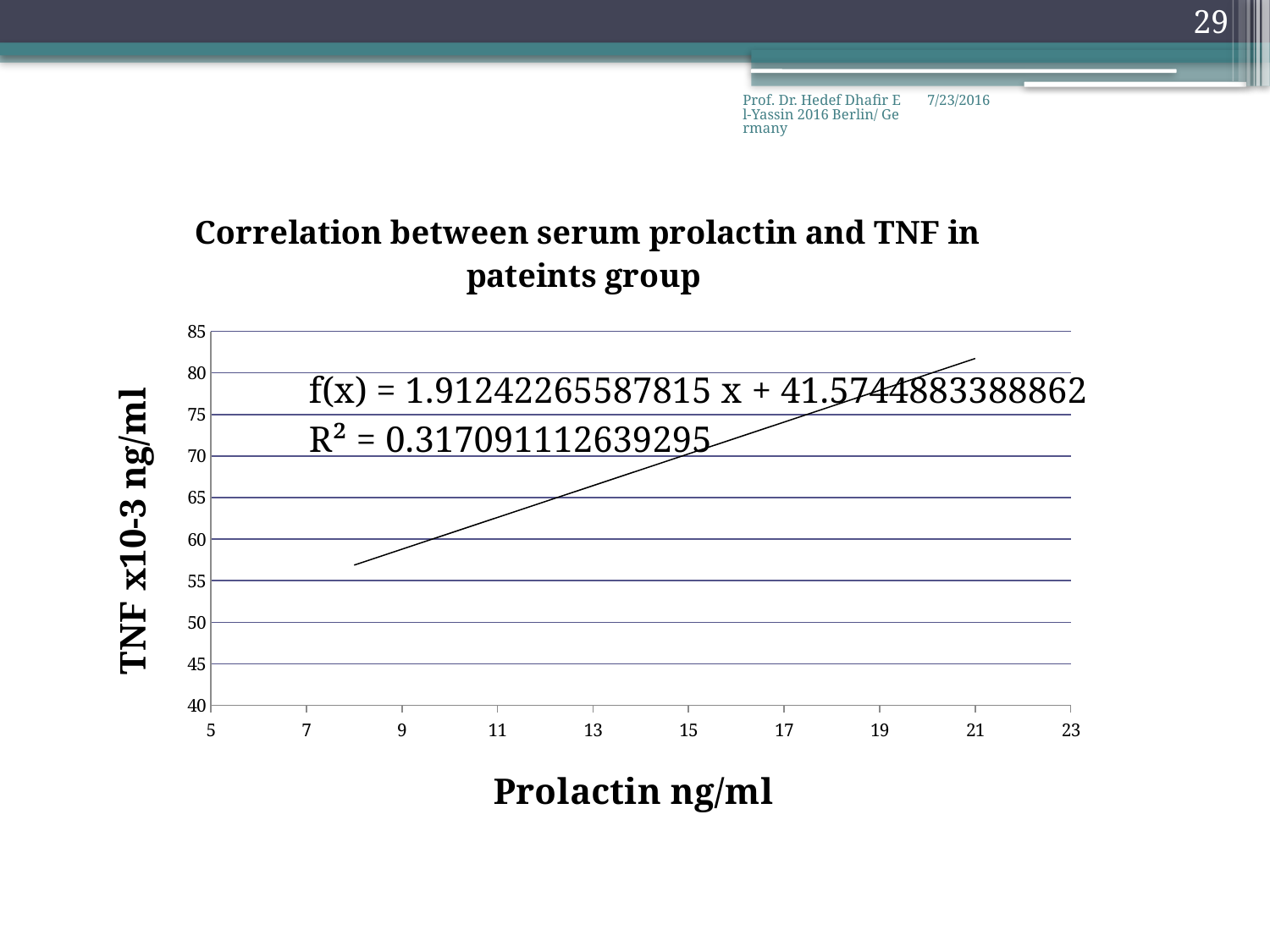
What is the title of the chart? Correlation between serum prolactin and TNF in pateints group What is the slope of the trendline shown on the chart? 1.91242265587815 Does the trendline rise or fall as prolactin increases along the x axis? rise What is the minimum value shown on the x axis? 5 What is the trendline equation shown on the chart? f(x) = 1.91242265587815 x + 41.5744883388862 What is the intercept of the trendline shown on the chart? 41.5744883388862 Is the trendline value at a prolactin of 8 ng/ml greater or less than 60? less What is the maximum value shown on the y axis? 85 What is the R² value shown on the chart? 0.317091112639295 Is the trendline value at a prolactin of 21 ng/ml greater or less than 80? greater